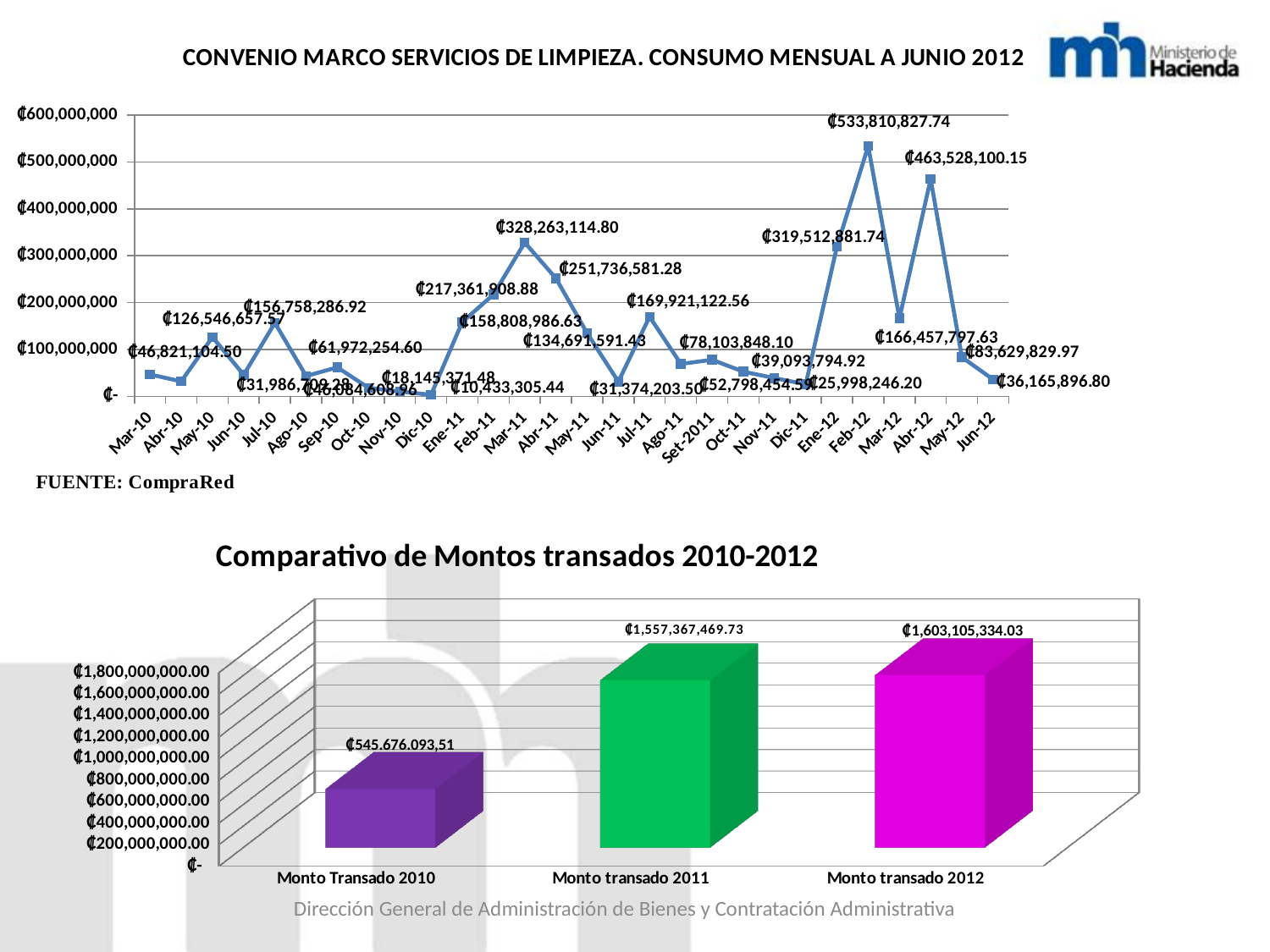
In the top chart 'CONVENIO MARCO SERVICIOS DE LIMPIEZA. CONSUMO MENSUAL A JUNIO 2012', which month has the highest value? Feb-12 In the bottom chart 'Comparativo de Montos transados 2010-2012', what is the value for Monto Transado 2010? ₡545.676.093,51 In the top chart 'CONVENIO MARCO SERVICIOS DE LIMPIEZA. CONSUMO MENSUAL A JUNIO 2012', what is the value for Abr-12? ₡463,528,100.15 In the top chart 'CONVENIO MARCO SERVICIOS DE LIMPIEZA. CONSUMO MENSUAL A JUNIO 2012', is the value for Mar-11 greater or less than ₡300,000,000? greater What kind of chart is the top chart 'CONVENIO MARCO SERVICIOS DE LIMPIEZA. CONSUMO MENSUAL A JUNIO 2012'? Line chart In the bottom chart 'Comparativo de Montos transados 2010-2012', what is the value for Monto transado 2012? ₡1,603,105,334.03 In the bottom chart 'Comparativo de Montos transados 2010-2012', which category has the lowest value? Monto Transado 2010 In the top chart 'CONVENIO MARCO SERVICIOS DE LIMPIEZA. CONSUMO MENSUAL A JUNIO 2012', what is the value for Feb-12? ₡533,810,827.74 In the bottom chart 'Comparativo de Montos transados 2010-2012', what is the difference between Monto transado 2012 and Monto transado 2011? ₡45,737,864.30 In the bottom chart 'Comparativo de Montos transados 2010-2012', what is the value for Monto transado 2011? ₡1,557,367,469.73 What kind of chart is the bottom chart 'Comparativo de Montos transados 2010-2012'? Bar chart In the bottom chart 'Comparativo de Montos transados 2010-2012', how many categories are shown? 3